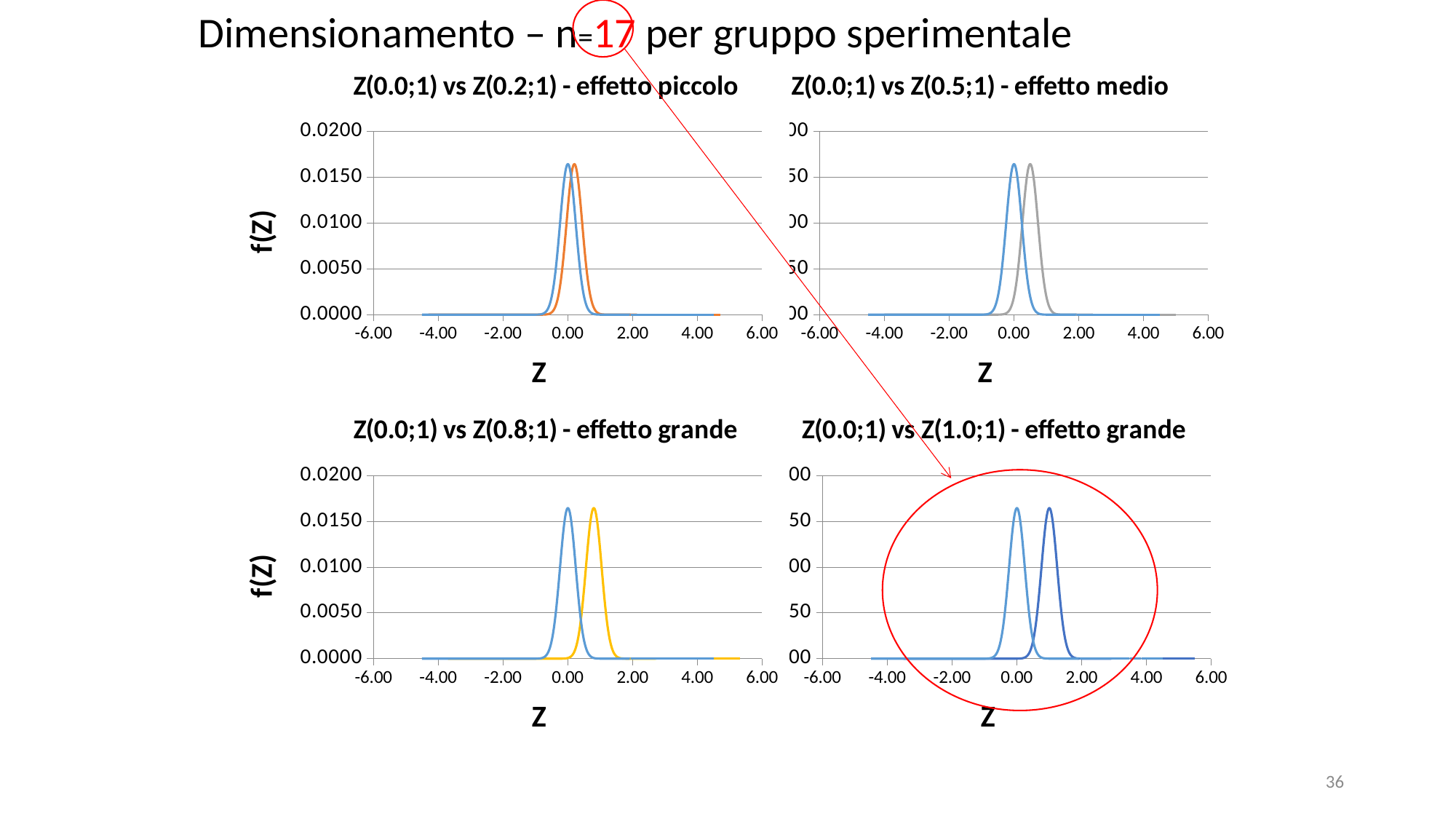
What kind of chart is the top-left chart titled 'Z(0.0;1) vs Z(0.2;1) - effetto piccolo'? line chart In the bottom-left chart 'Z(0.0;1) vs Z(0.8;1) - effetto grande', does the yellow curve rise or fall as Z goes from 1.00 to 2.00? fall In the top-right chart 'Z(0.0;1) vs Z(0.5;1) - effetto medio', is the peak of the grey curve greater or less than 0.0100? greater In the bottom-left chart 'Z(0.0;1) vs Z(0.8;1) - effetto grande', is the peak of the yellow curve greater or less than 0.0100? greater In the top-left chart 'Z(0.0;1) vs Z(0.2;1) - effetto piccolo', is the peak value of the curves greater or less than 0.0200? less How many charts are shown on the slide? 4 How many curves are plotted in the bottom-left chart titled 'Z(0.0;1) vs Z(0.8;1) - effetto grande'? 2 What is the title of the top-right chart on the slide? Z(0.0;1) vs Z(0.5;1) - effetto medio In the top-left chart 'Z(0.0;1) vs Z(0.2;1) - effetto piccolo', does the blue curve rise or fall as Z goes from -2.00 to 0.00? rise In the bottom-left chart 'Z(0.0;1) vs Z(0.8;1) - effetto grande', which curve peaks at a larger value of Z, the blue one or the yellow one? the yellow one